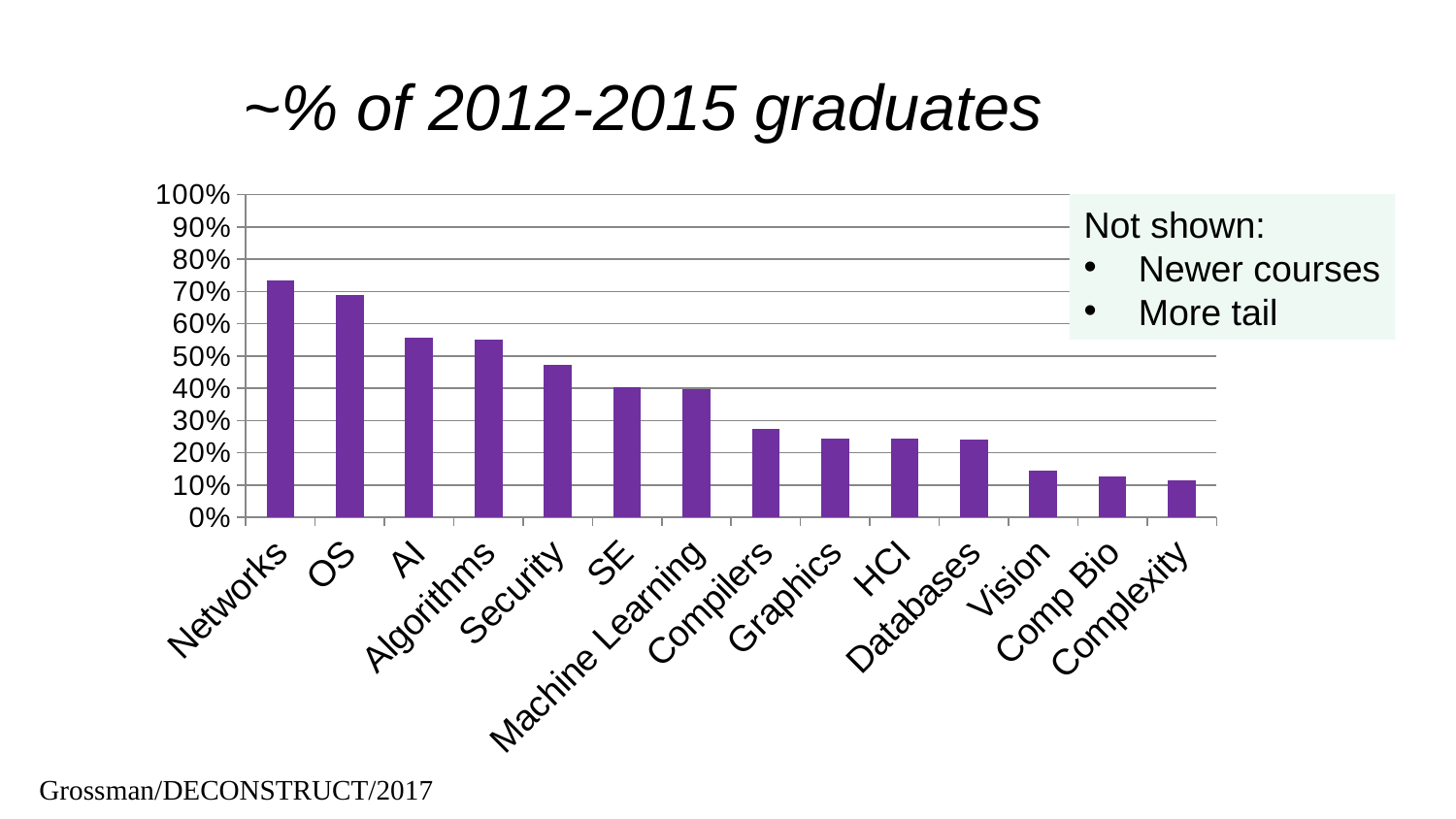
Is the value for Compilers greater or less than 30%? less Is the value for Security greater or less than 50%? less Is the value for Networks greater or less than 70%? greater Do the values generally rise or fall moving from left to right along the x axis? fall What is the title of the chart? ~% of 2012-2015 graduates How many categories are plotted on the x axis? 14 What kind of chart is shown on the slide? bar chart Which is larger, the value for Security or the value for Compilers? Security Which category has the highest value? Networks Which is larger, the value for AI or the value for Graphics? AI